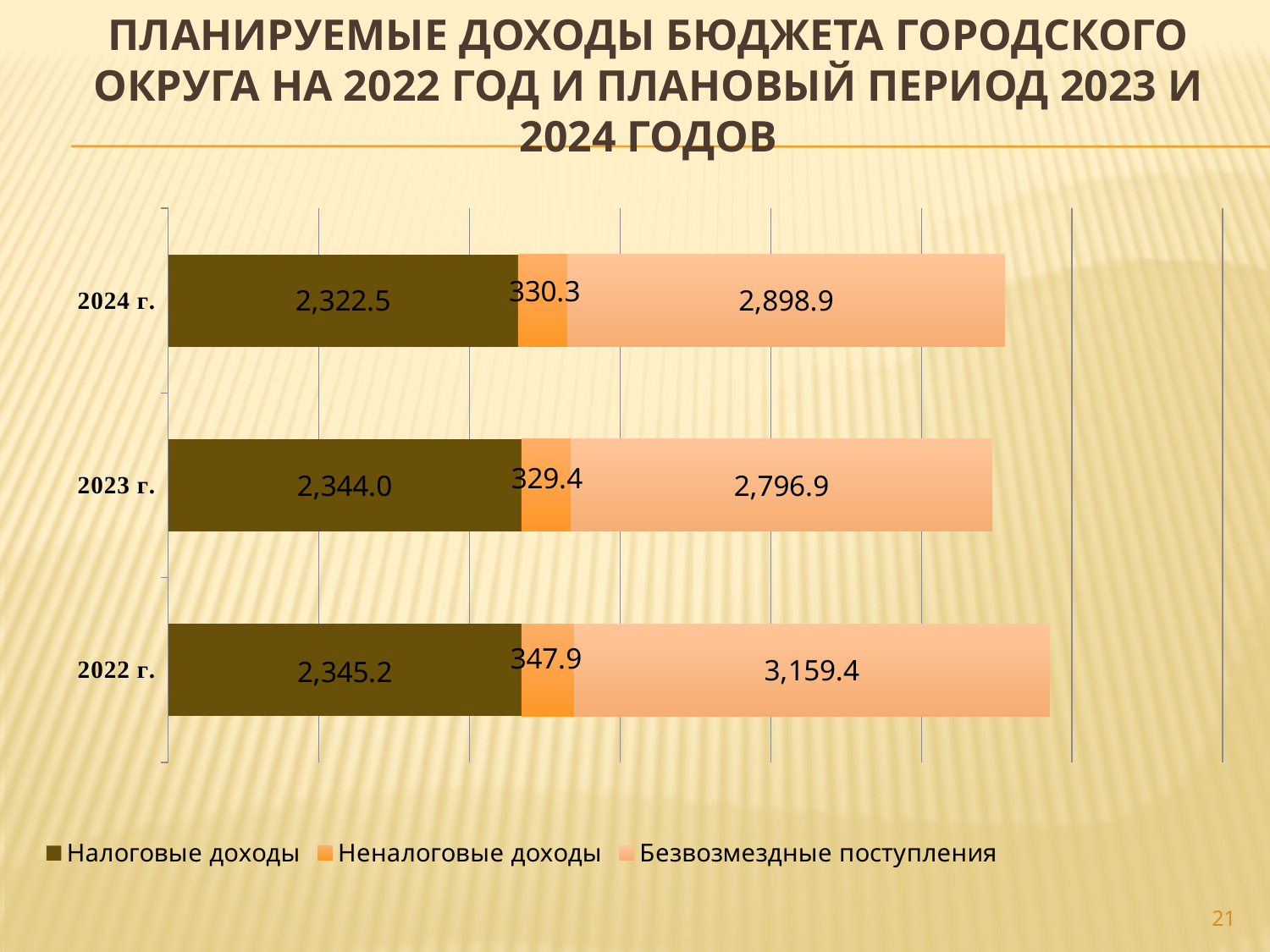
How many years (categories) are shown on the chart? 3 In which year is the value of Безвозмездные поступления the highest? 2022 г. What is the difference between Безвозмездные поступления in 2022 г. and 2023 г.? 362.5 In which year is the value of Налоговые доходы the lowest? 2024 г. How many series does the legend list? 3 Which is larger: Неналоговые доходы in 2022 г. or in 2024 г.? 2022 г. What is the value of Неналоговые доходы for 2023 г.? 329.4 What type of chart is shown on the slide? stacked bar chart What is the value of Налоговые доходы for 2022 г.? 2,345.2 What is the total of the stacked bar for 2022 г.? 5,852.5 What is the value of Безвозмездные поступления for 2024 г.? 2,898.9 What is the total of the stacked bar for 2023 г.? 5,470.3